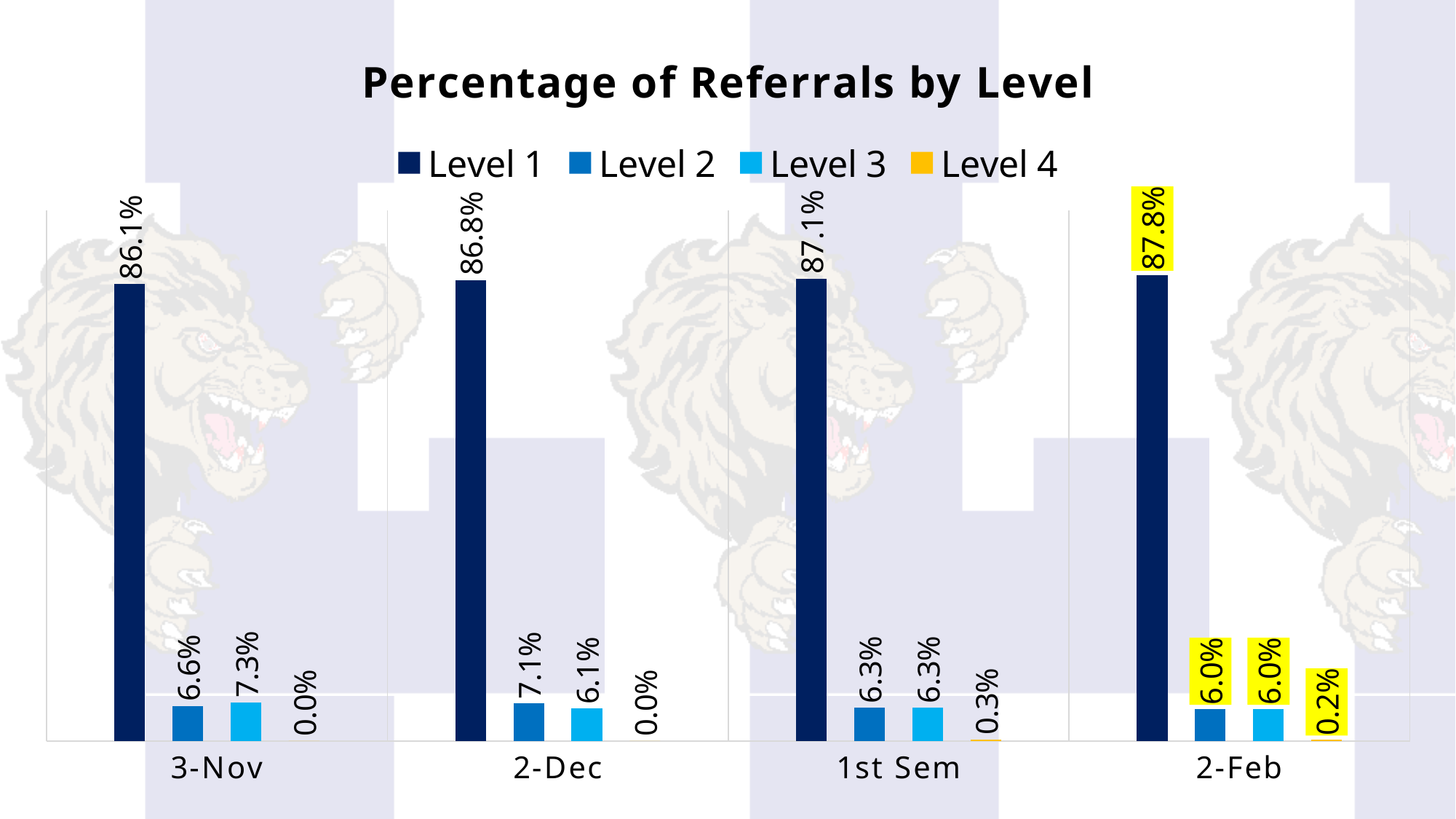
Which is larger for 3-Nov, Level 2 or Level 3? Level 3 What is the difference between the Level 1 values for 2-Feb and 3-Nov? 1.7% What is the Level 2 value for 2-Dec? 7.1% How many series does the legend list? 4 How many categories are shown on the x axis? 4 What is the Level 1 value for 2-Feb? 87.8% Which category has the highest Level 1 value? 2-Feb What is the Level 4 value for 1st Sem? 0.3% What kind of chart is this? Bar chart What is the Level 3 value for 3-Nov? 7.3% What is the title of the chart? Percentage of Referrals by Level Which category has the lowest Level 2 value? 2-Feb